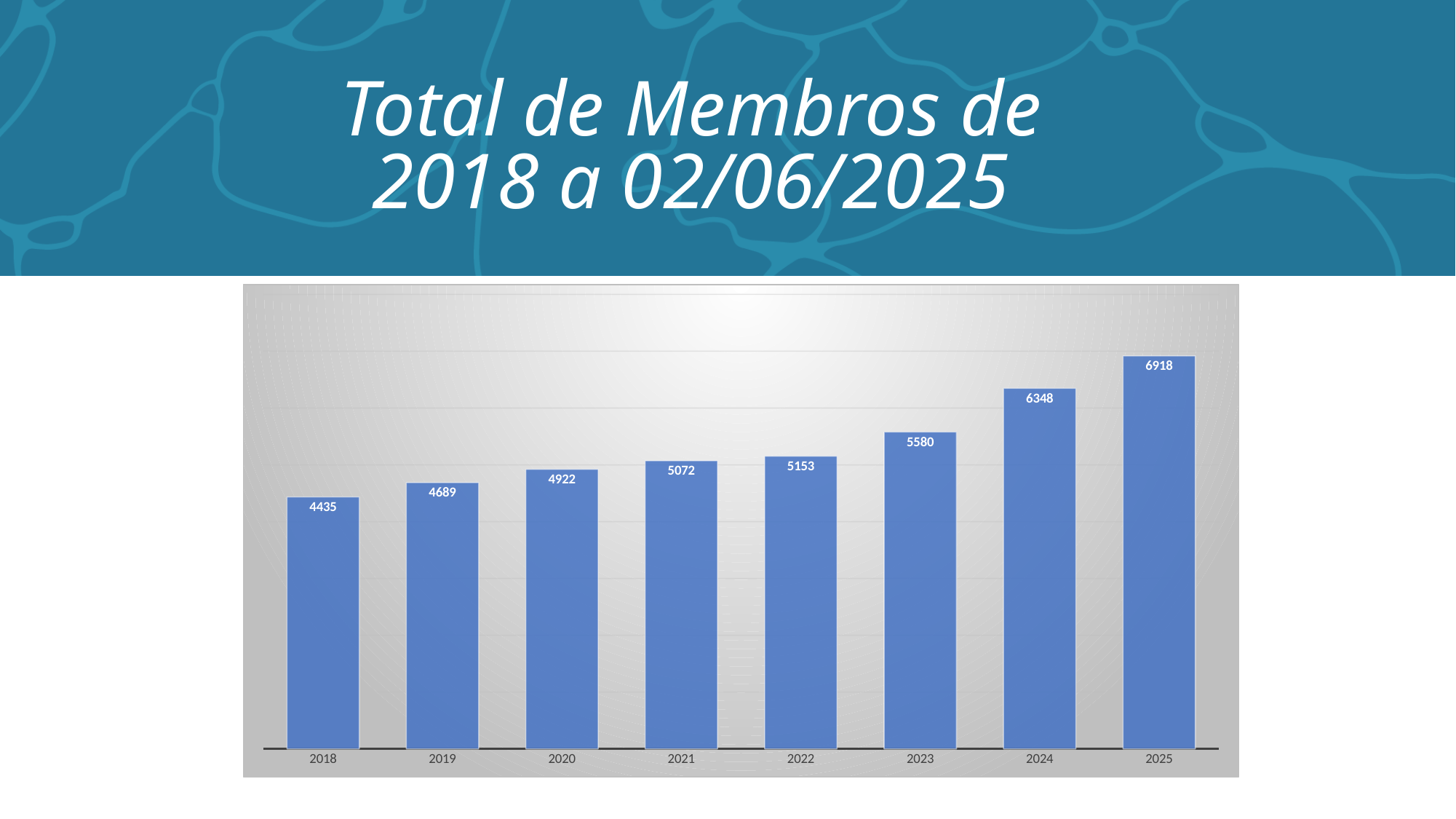
Which year has the highest value? 2025 What is the value for 2022? 5153 How many years are shown on the x axis? 8 Which year has the lowest value? 2018 What is the value for 2025? 6918 What is the value for 2018? 4435 What kind of chart is shown on the slide? bar chart Which is larger, the value for 2020 or the value for 2021? 2021 Do the values rise or fall from 2018 to 2025? rise What is the title of the slide? Total de Membros de 2018 a 02/06/2025 What is the difference between the values for 2025 and 2024? 570 What is the difference between the values for 2023 and 2018? 1145